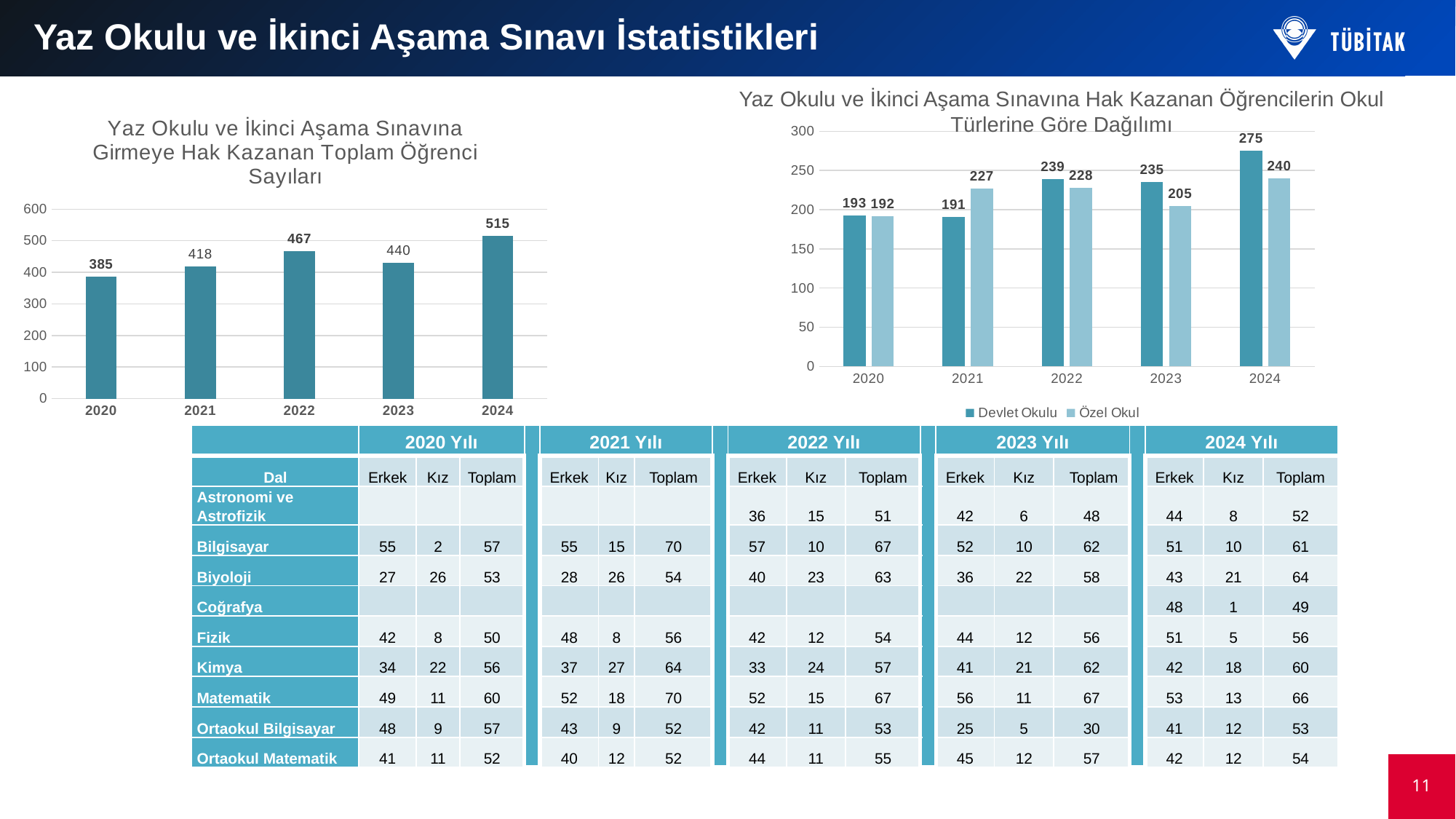
How many series does the legend of the right chart (Okul Türlerine Göre Dağılımı) list? 2 In the right chart (Okul Türlerine Göre Dağılımı), what is the Devlet Okulu value for 2021? 191 In the left chart (Toplam Öğrenci Sayıları), how many years are shown on the x axis? 5 In the right chart (Okul Türlerine Göre Dağılımı), which is larger for 2021: Devlet Okulu or Özel Okul? Özel Okul In the right chart (Okul Türlerine Göre Dağılımı), which year has the highest Devlet Okulu value? 2024 In the left chart (Toplam Öğrenci Sayıları), what is the value for 2022? 467 In the left chart (Toplam Öğrenci Sayıları), which year has the lowest value? 2020 In the right chart (Okul Türlerine Göre Dağılımı), what is the difference between Devlet Okulu and Özel Okul in 2024? 35 What kind of chart is the left chart (Toplam Öğrenci Sayıları)? Bar chart In the left chart (Toplam Öğrenci Sayıları), what is the difference between the values for 2024 and 2023? 75 In the left chart (Toplam Öğrenci Sayıları), which year has the highest value? 2024 In the right chart (Okul Türlerine Göre Dağılımı), what is the Özel Okul value for 2023? 205